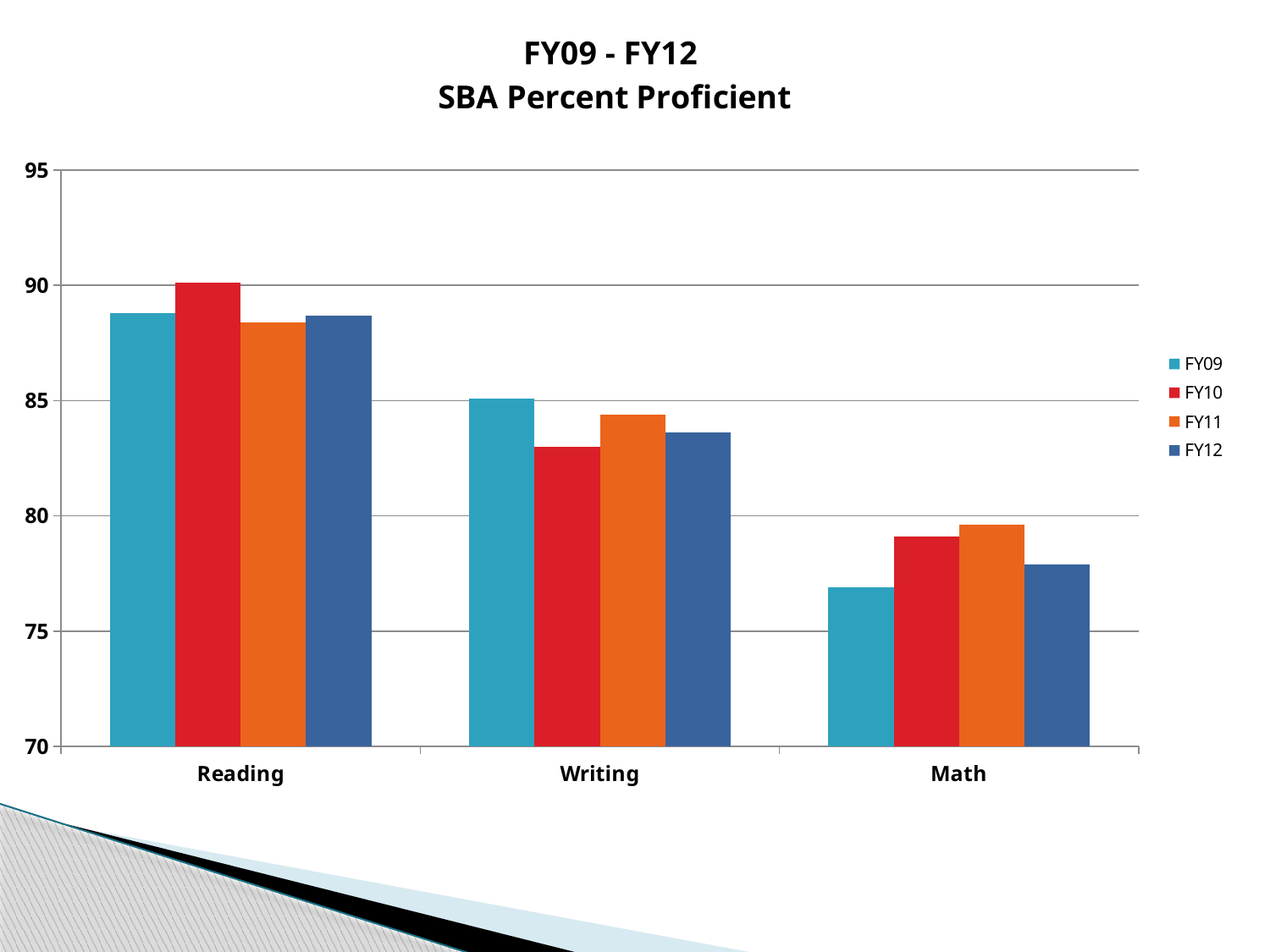
Which fiscal year has the highest percent proficient in Reading? FY10 Do the FY12 values rise or fall moving from Reading to Writing to Math? fall Which fiscal year has the lowest percent proficient in Math? FY09 Which is larger, the FY09 value for Reading or the FY09 value for Writing? Reading Is the FY10 value for Writing greater or less than 85? less What kind of chart is shown on the slide? bar chart Is the FY09 value for Reading greater or less than 85? greater How many subject categories are shown on the x axis? 3 Which fiscal year has the lowest percent proficient in Writing? FY10 Which subject has the highest bar on the chart? Reading Is the FY09 value for Math greater or less than 80? less How many series does the legend list? 4